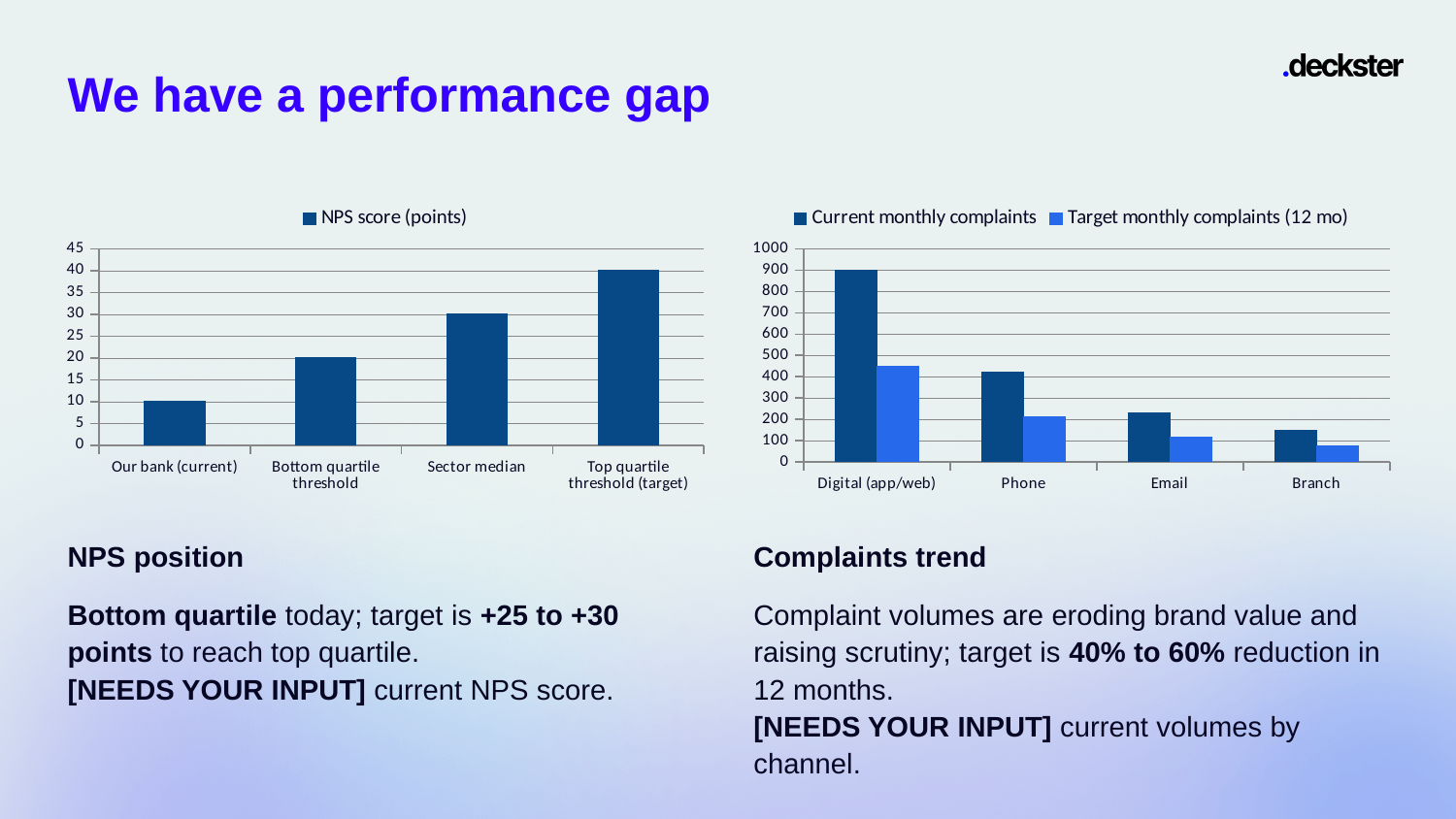
On the complaints chart on the right, which is larger: current monthly complaints for Phone or for Email? Phone On the NPS score (points) chart, what is the difference between Sector median and Our bank (current)? 20 On the NPS score (points) chart, do the values rise or fall from left to right? rise On the NPS score (points) chart, which category has the highest value? Top quartile threshold (target) On the NPS score (points) chart, which category has the lowest value? Our bank (current) What kind of chart is the chart on the right? bar chart On the complaints chart on the right, is the value for Target monthly complaints (12 mo) for Phone greater or less than 300? less On the NPS score (points) chart, how many categories are shown? 4 On the NPS score (points) chart, what is the value for Our bank (current)? 10 On the complaints chart on the right, which channel has the highest current monthly complaints? Digital (app/web) On the complaints chart on the right, how many series does the legend list? 2 On the NPS score (points) chart, what is the value for Top quartile threshold (target)? 40